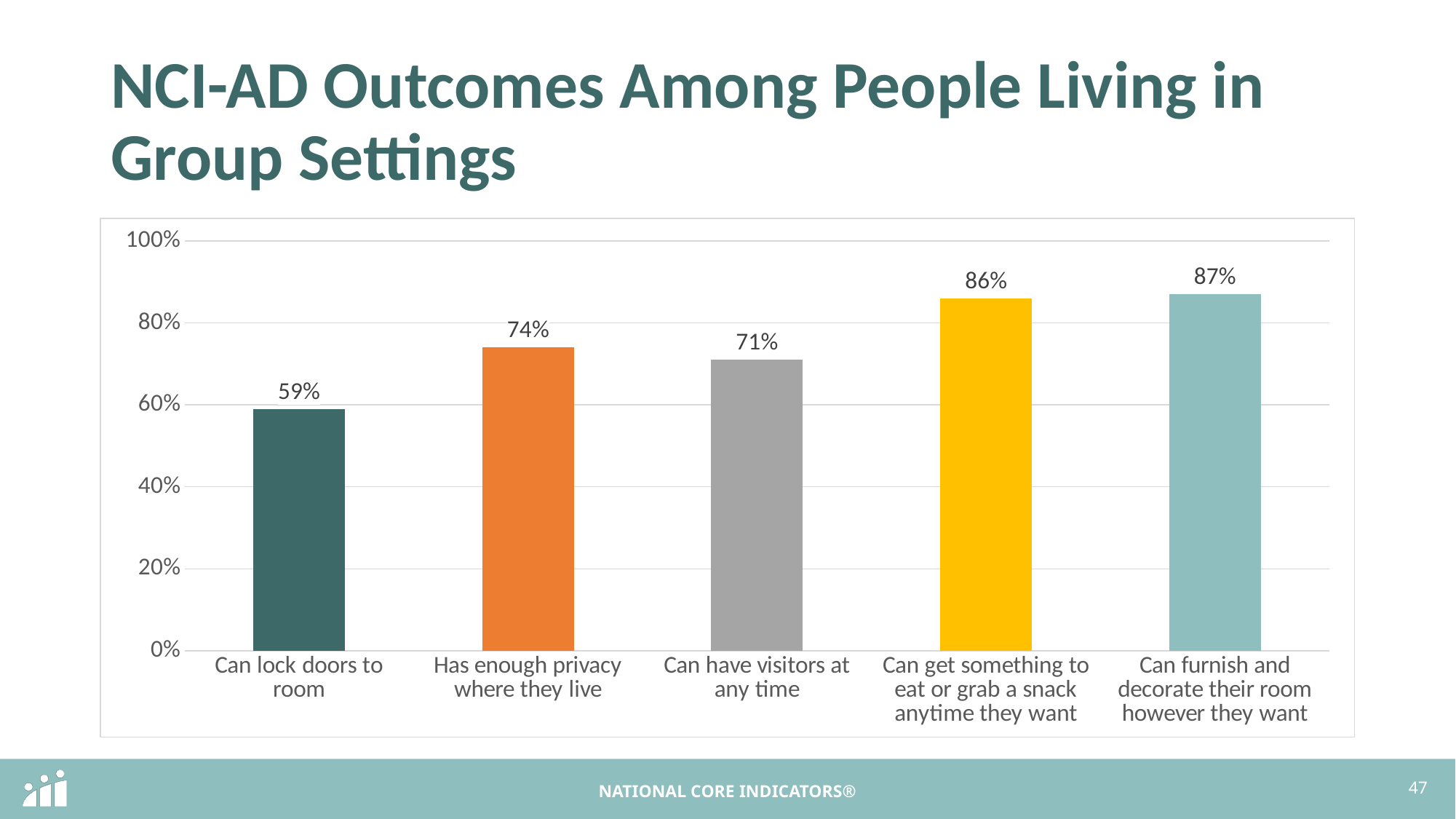
What percentage of people living in group settings can lock doors to their room? 59% What is the difference between 'Has enough privacy where they live' and 'Can lock doors to room'? 15% How many categories are shown in the chart? 5 What kind of chart is shown on the slide? Bar chart What is the value for 'Can get something to eat or grab a snack anytime they want'? 86% What colour is the bar for 'Has enough privacy where they live'? Orange Which category has the lowest value? Can lock doors to room Which category has the highest value? Can furnish and decorate their room however they want What is the value for 'Can have visitors at any time'? 71% What is the title of the slide? NCI-AD Outcomes Among People Living in Group Settings Is the value for 'Can furnish and decorate their room however they want' greater or less than 80%? greater Which is larger: 'Has enough privacy where they live' or 'Can have visitors at any time'? Has enough privacy where they live